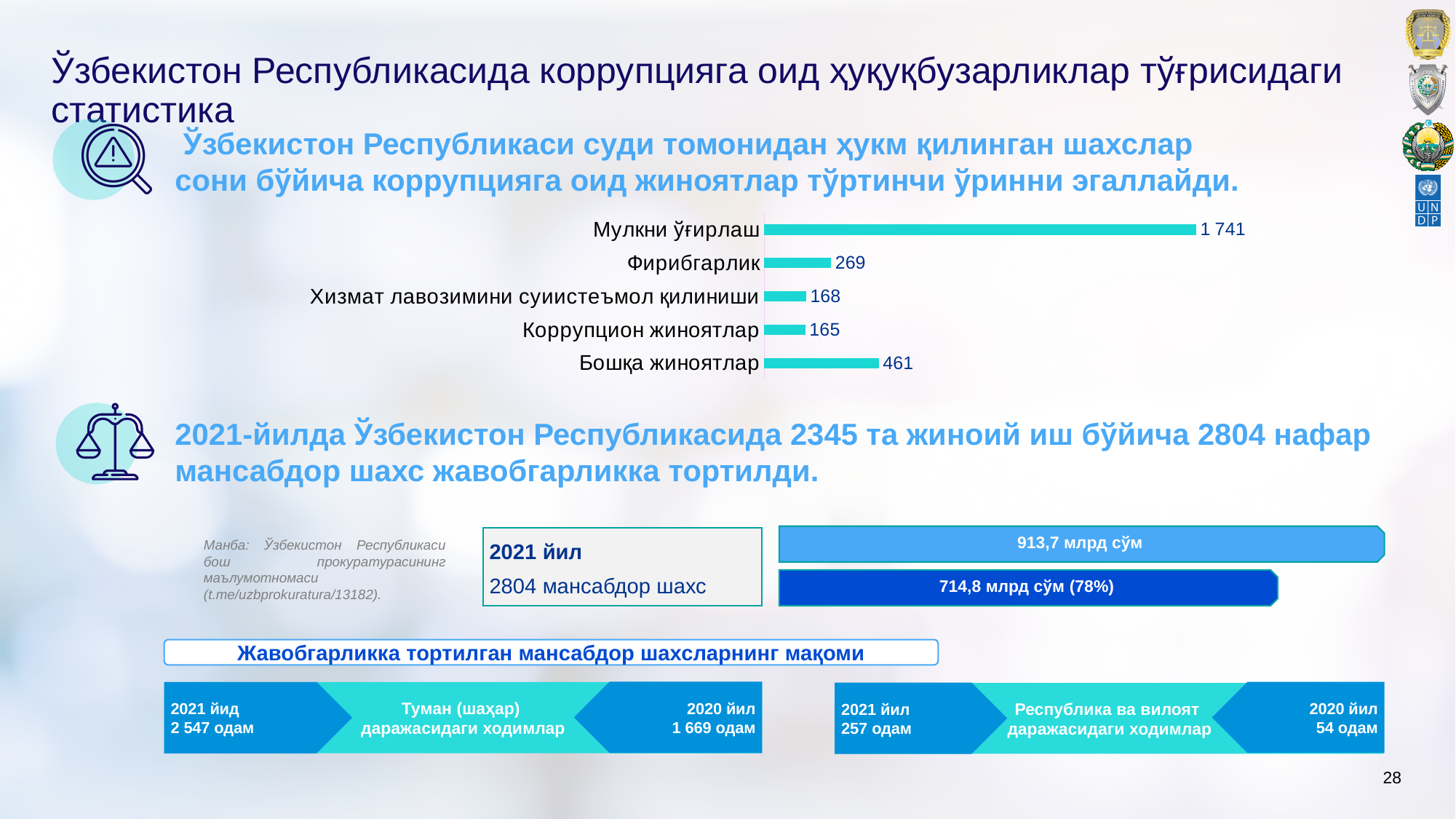
Which category has the highest value in the bar chart? Мулкни ўғирлаш What is the value for Мулкни ўғирлаш in the bar chart? 1 741 What is the difference between the values for Фирибгарлик and Коррупцион жиноятлар in the bar chart? 104 How many categories are shown in the bar chart? 5 What is the difference between the values for Мулкни ўғирлаш and Бошқа жиноятлар in the bar chart? 1 280 What is the value for Коррупцион жиноятлар in the bar chart? 165 Which category has the lowest value in the bar chart? Коррупцион жиноятлар What type of chart is used to show the crime categories on the slide? Bar chart What is the value for Бошқа жиноятлар in the bar chart? 461 What is the value for Фирибгарлик in the bar chart? 269 What is the value for Хизмат лавозимини суиистеъмол қилиниши in the bar chart? 168 Which is larger in the bar chart: Бошқа жиноятлар or Фирибгарлик? Бошқа жиноятлар